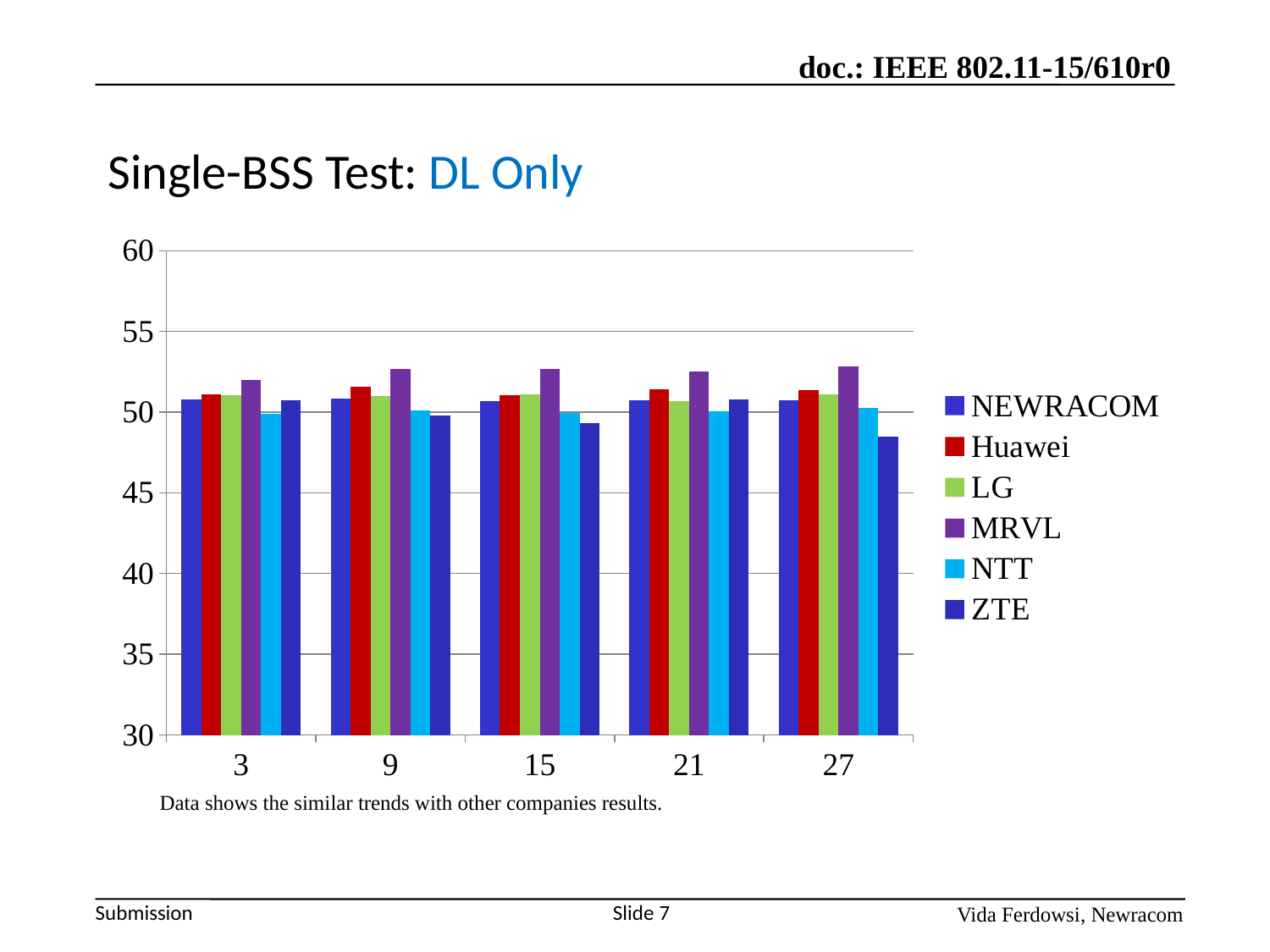
At category 21, which is larger: the value for MRVL or the value for ZTE? MRVL Which series has the highest value at category 27? MRVL Which series is shown in red in the legend? Huawei Which series has the highest value at category 9? MRVL What kind of chart is shown on the slide? bar chart How many series does the legend list? 6 What is the title of the slide containing the chart? Single-BSS Test: DL Only Which series has the lowest value at category 27? ZTE Is the value for MRVL at category 15 greater or less than 55? less Is the value for NEWRACOM at category 3 greater or less than 45? greater Is the value for ZTE at category 27 greater or less than 50? less How many categories are shown along the x axis? 5